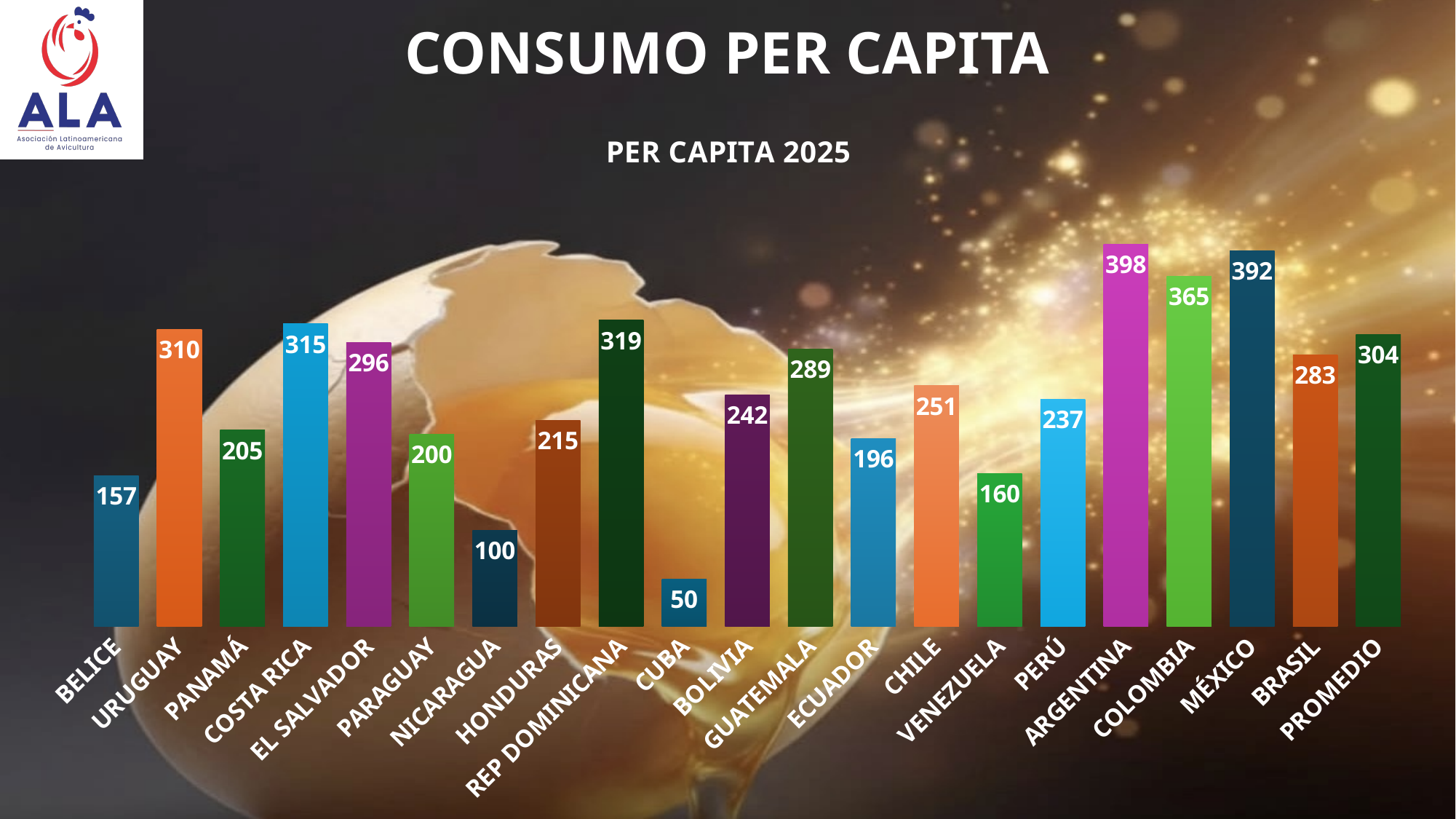
What is the subtitle shown above the chart? PER CAPITA 2025 How many bars are plotted on the chart? 21 What type of chart is shown on the slide? Bar chart What is the difference between the values for Uruguay and Belice? 153 Which country has the lowest per capita consumption on the chart? Cuba What is the per capita consumption value shown for Argentina? 398 What value is shown for Rep Dominicana? 319 What is the value labelled for PROMEDIO? 304 Which country has the highest per capita consumption on the chart? Argentina What is the difference between the values for Argentina and México? 6 Which has a higher value, Colombia or Brasil? Colombia What value is shown for Cuba? 50